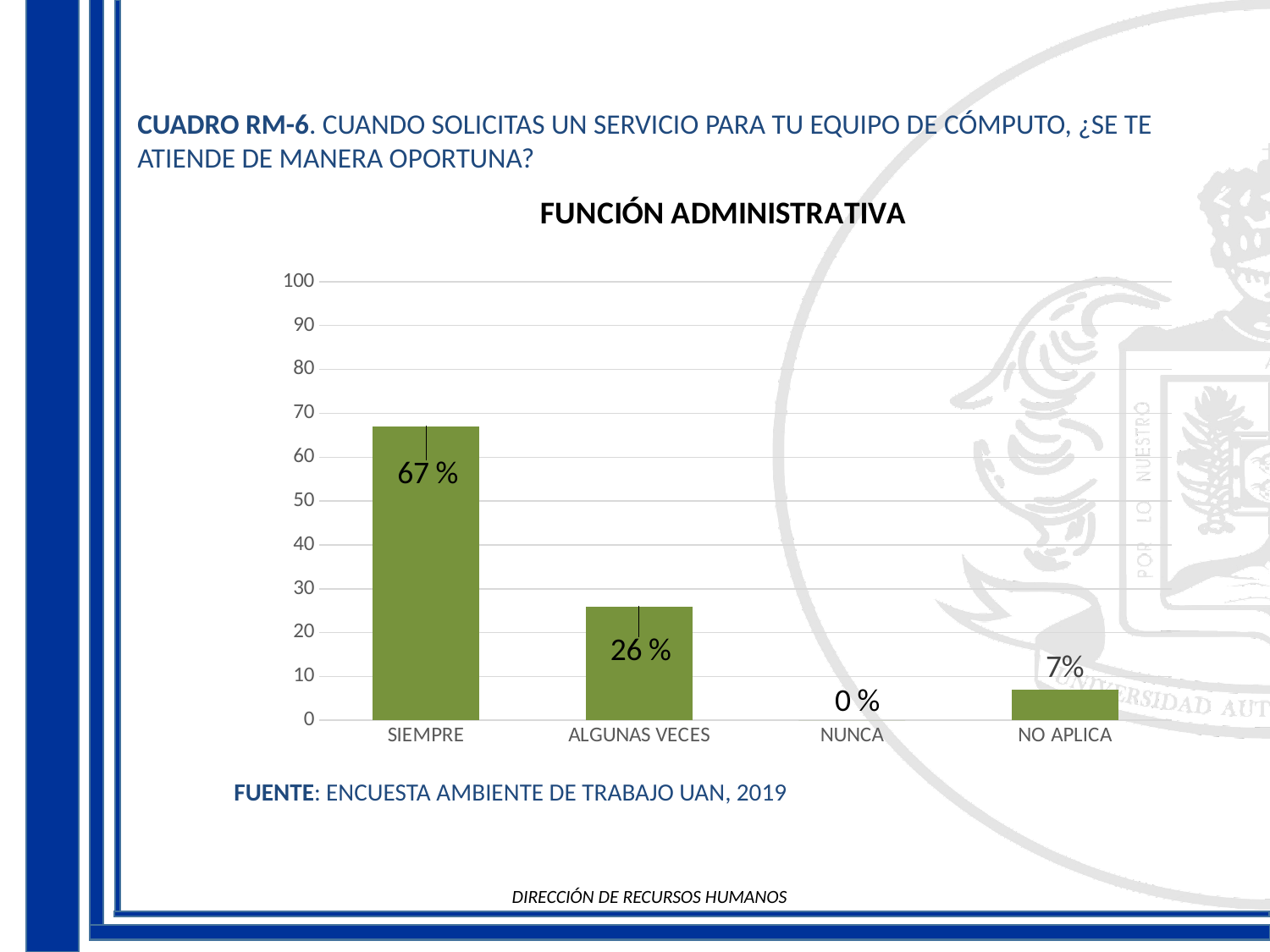
Is the value for SIEMPRE greater or less than 60? greater Which category has the highest value? SIEMPRE What is the value for SIEMPRE? 67 % What is the value for NUNCA? 0 % What kind of chart is shown on the slide? bar chart What is the value for NO APLICA? 7% Which is larger, the value for ALGUNAS VECES or the value for NO APLICA? ALGUNAS VECES What is the difference between the values for SIEMPRE and ALGUNAS VECES? 41 % What is the title of the chart? FUNCIÓN ADMINISTRATIVA How many categories are shown on the x axis? 4 What is the value for ALGUNAS VECES? 26 % Which category has the lowest value? NUNCA